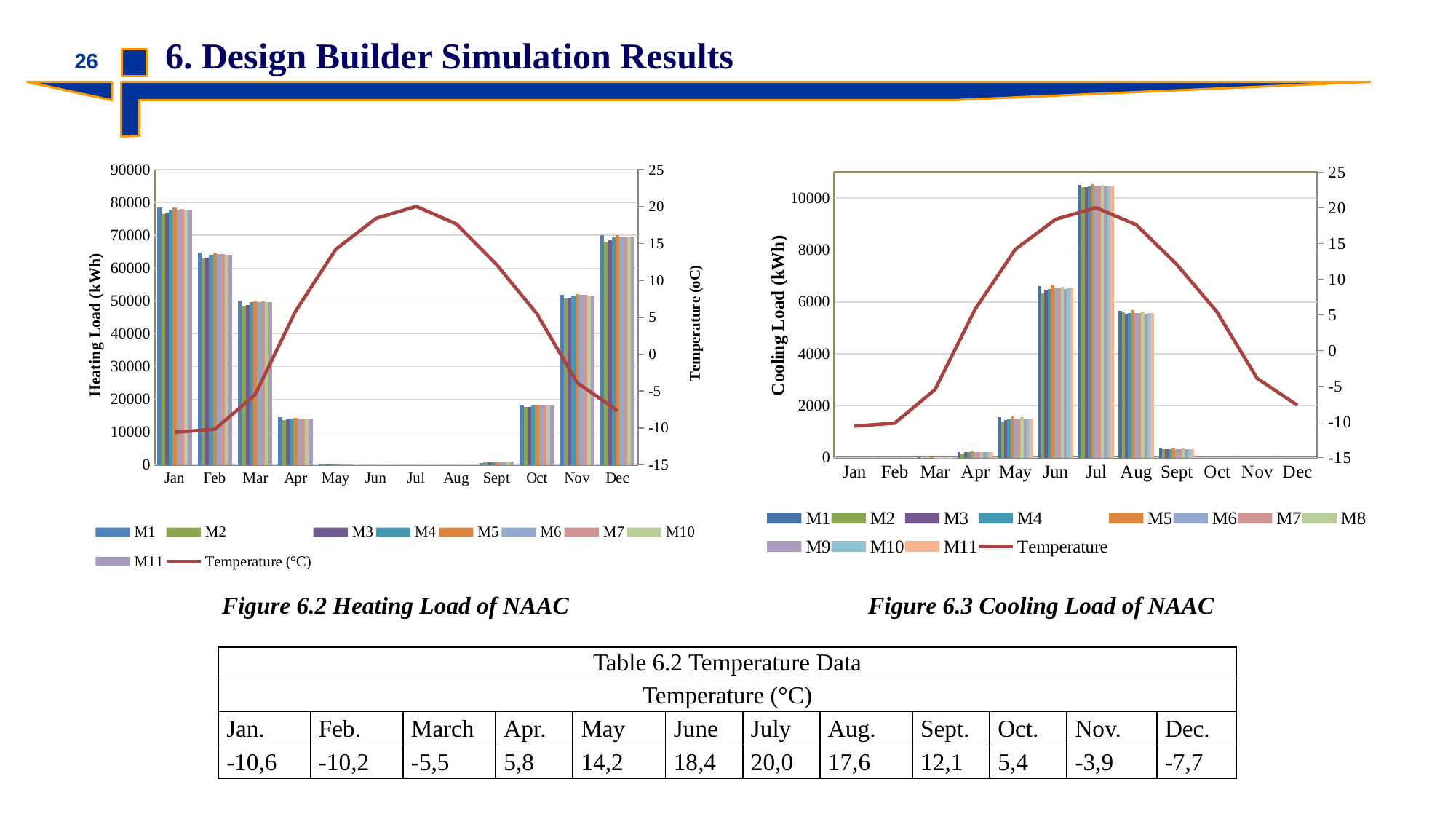
In the Heating Load of NAAC chart, which month has the larger heating load, Jan or Feb? Jan In the Cooling Load of NAAC chart, which month has the highest cooling load? Jul In the Heating Load of NAAC chart, is the heating load for M1 in Jan greater or less than 70000? greater In the Heating Load of NAAC chart, which month has the highest heating load? Jan In the Cooling Load of NAAC chart, is the cooling load for M1 in Aug greater or less than 6000? less In the Cooling Load of NAAC chart, is the cooling load for M1 in Jul greater or less than 10000? greater In the Cooling Load of NAAC chart, which month has the larger cooling load, Jun or Aug? Jun In the Heating Load of NAAC chart, does the temperature line rise or fall from Jan to Jul? rise How many entries does the legend of the Cooling Load of NAAC chart list? 12 How many months are shown on the x axis of the Cooling Load of NAAC chart? 12